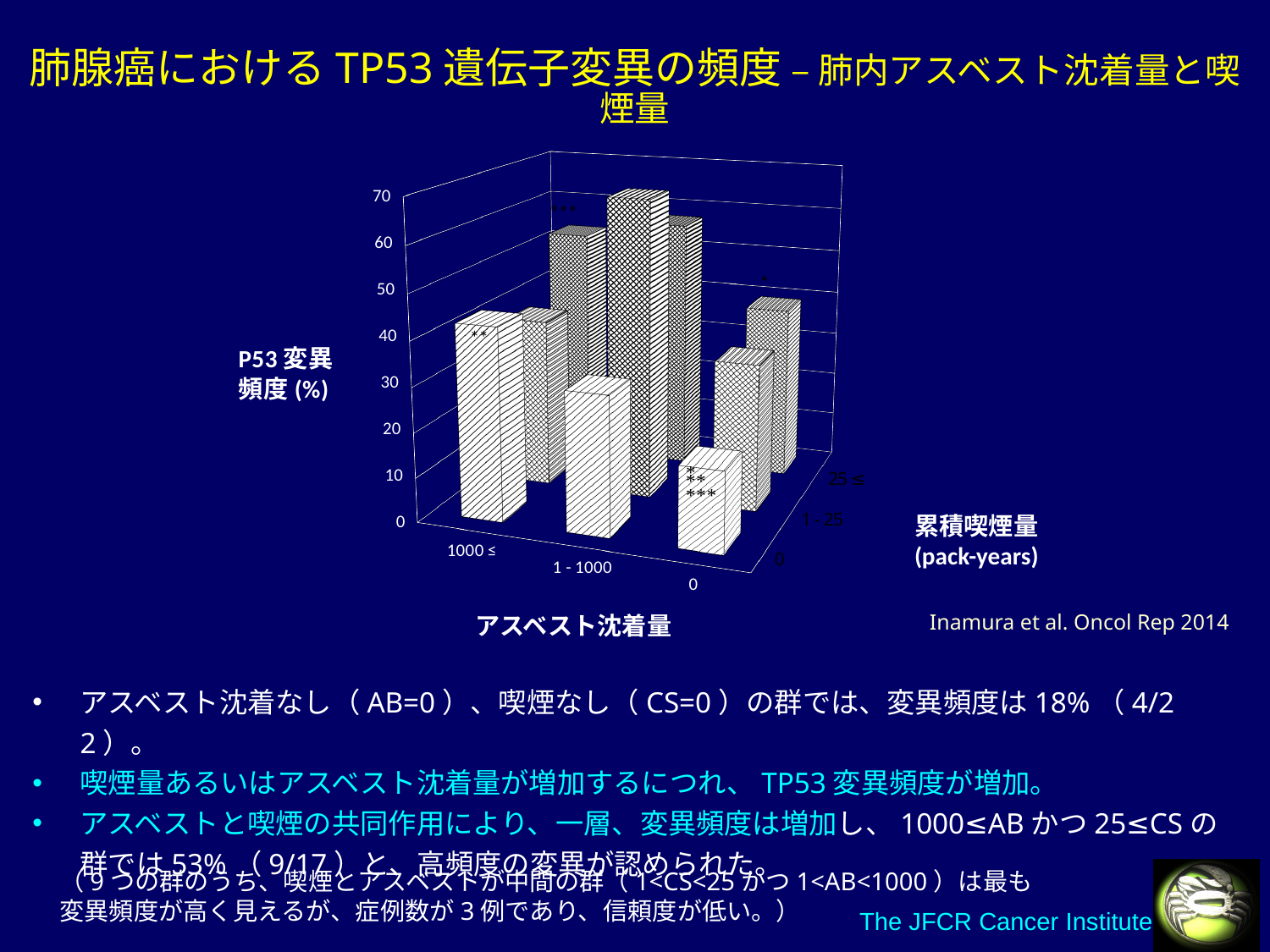
How many categories of アスベスト沈着量 are shown along the axis? 3 Is the value for the group with アスベスト沈着量 0 and 累積喫煙量 0 greater or less than 30? less How many bars are plotted in the chart? 9 Which combination of アスベスト沈着量 and 累積喫煙量 has the tallest bar in the chart? 1 - 1000 and 1 - 25 What is the unit given for 累積喫煙量 on the chart axis? pack-years What is the label of the vertical axis of the chart? P53 変異頻度 (%) What kind of chart is shown on the slide? bar chart How many categories of 累積喫煙量 (pack-years) are shown along the axis? 3 What is the highest tick value shown on the vertical axis? 70 Is the value for the group with アスベスト沈着量 1 - 1000 and 累積喫煙量 1 - 25 greater or less than 40? greater Which is larger: the bar for アスベスト沈着量 1000≤ with 累積喫煙量 25≤, or the bar for アスベスト沈着量 0 with 累積喫煙量 0? アスベスト沈着量 1000≤ with 累積喫煙量 25≤